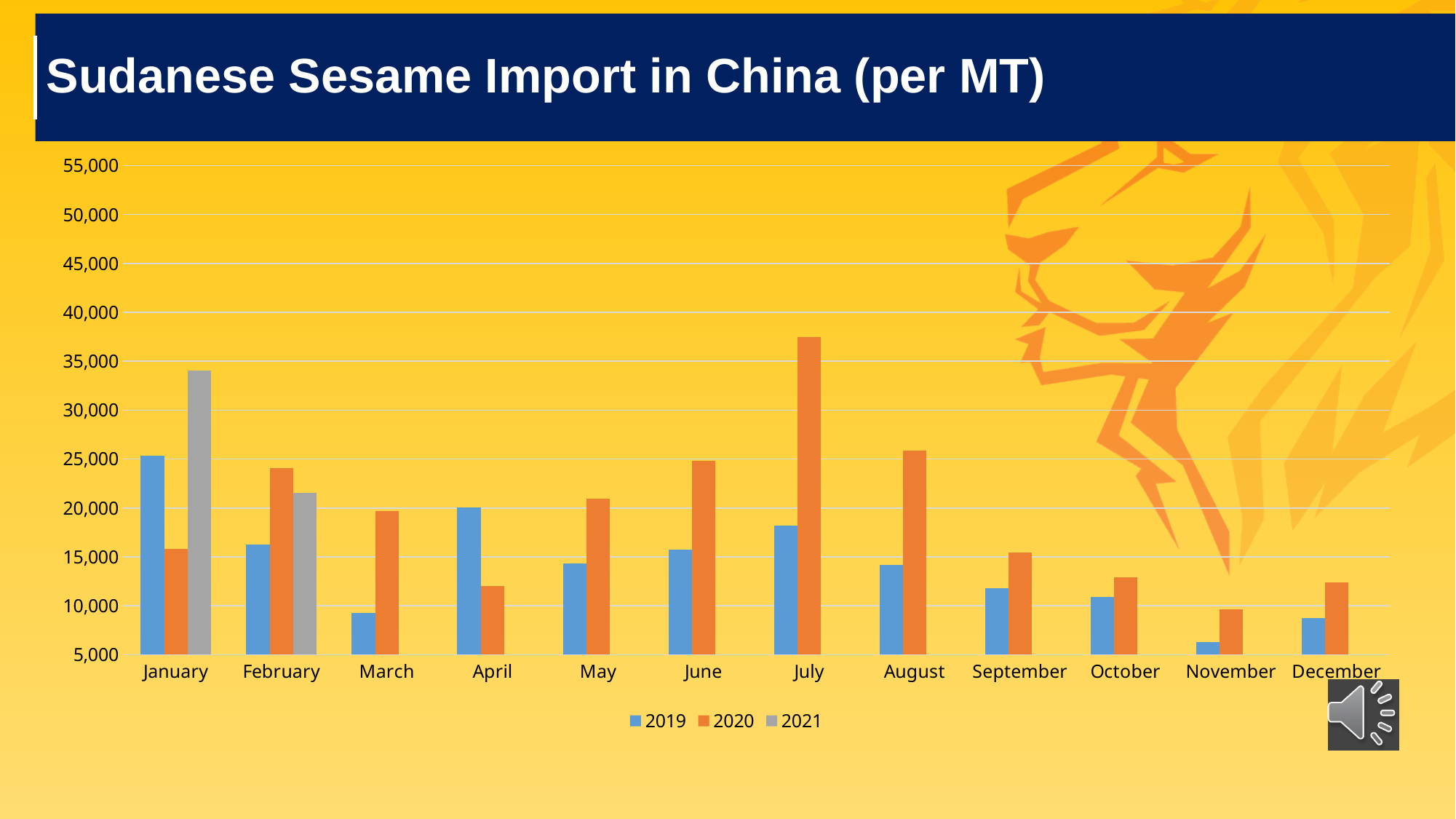
In which month is the 2020 value highest? July How many months are shown on the x axis? 12 For February, which series has the larger value, 2020 or 2021? 2020 How many series does the legend list? 3 For January, which series has the larger value, 2019 or 2020? 2019 What kind of chart is shown on the slide? Bar chart Is the 2019 value for March greater or less than 10,000? less Is the 2020 value for July greater or less than 35,000? greater Is the 2021 value for January greater or less than 30,000? greater In which month is the 2020 value lowest? November In which month is the 2019 value highest? January In which month is the 2019 value lowest? November